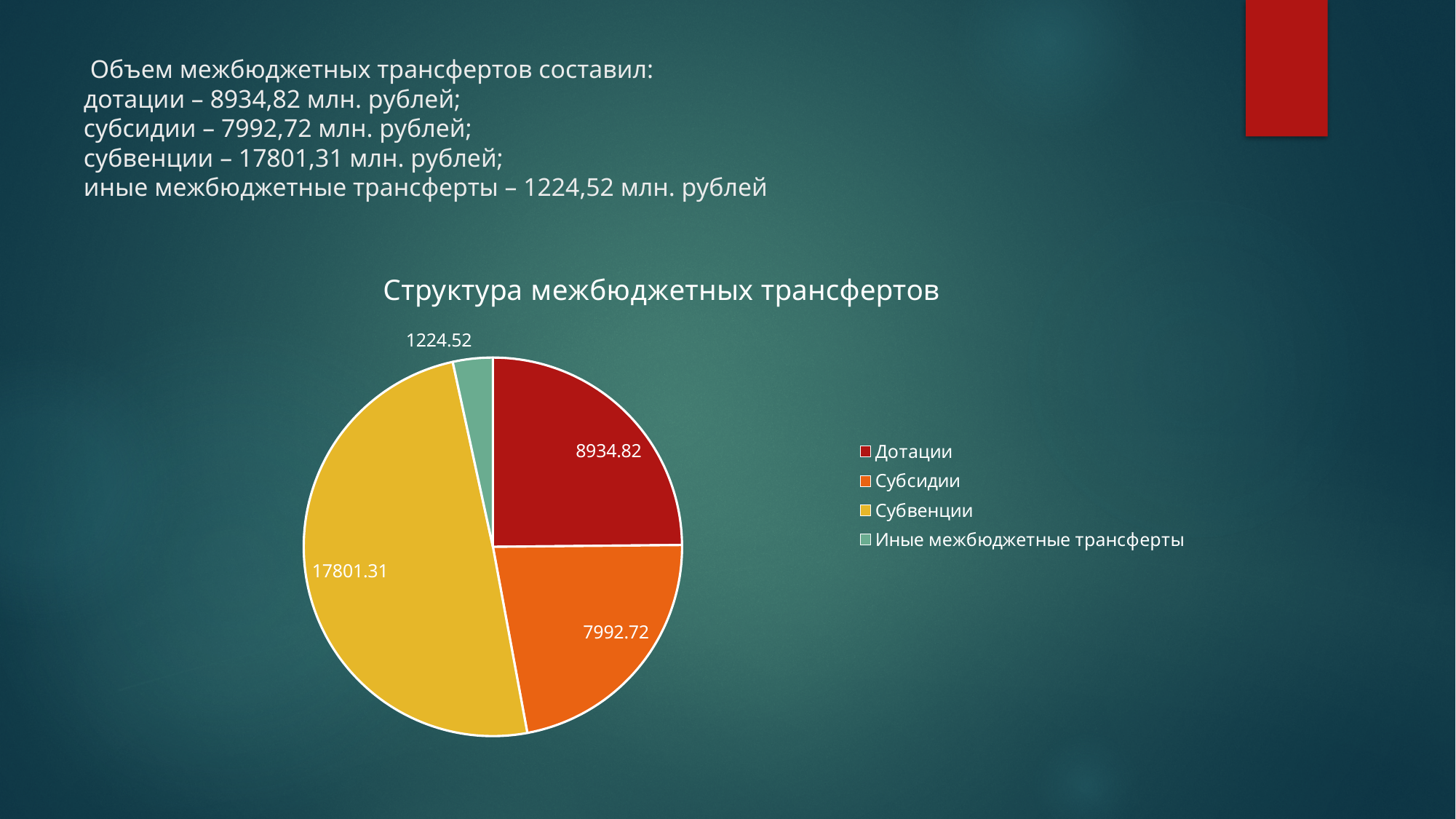
What is the difference between the values for Субвенции and Дотации? 8866.49 Which is larger in the pie chart, Дотации or Субсидии? Дотации What is the value for Дотации in the pie chart? 8934.82 How many slices does the pie chart have? 4 What is the value for Иные межбюджетные трансферты in the pie chart? 1224.52 Which category has the smallest slice in the pie chart? Иные межбюджетные трансферты What is the title of the chart? Структура межбюджетных трансфертов What is the value for Субвенции in the pie chart? 17801.31 What type of chart is shown on the slide? pie chart What is the difference between the values for Дотации and Субсидии? 942.10 Which category has the largest slice in the pie chart? Субвенции Which colour represents Субвенции in the pie chart? yellow